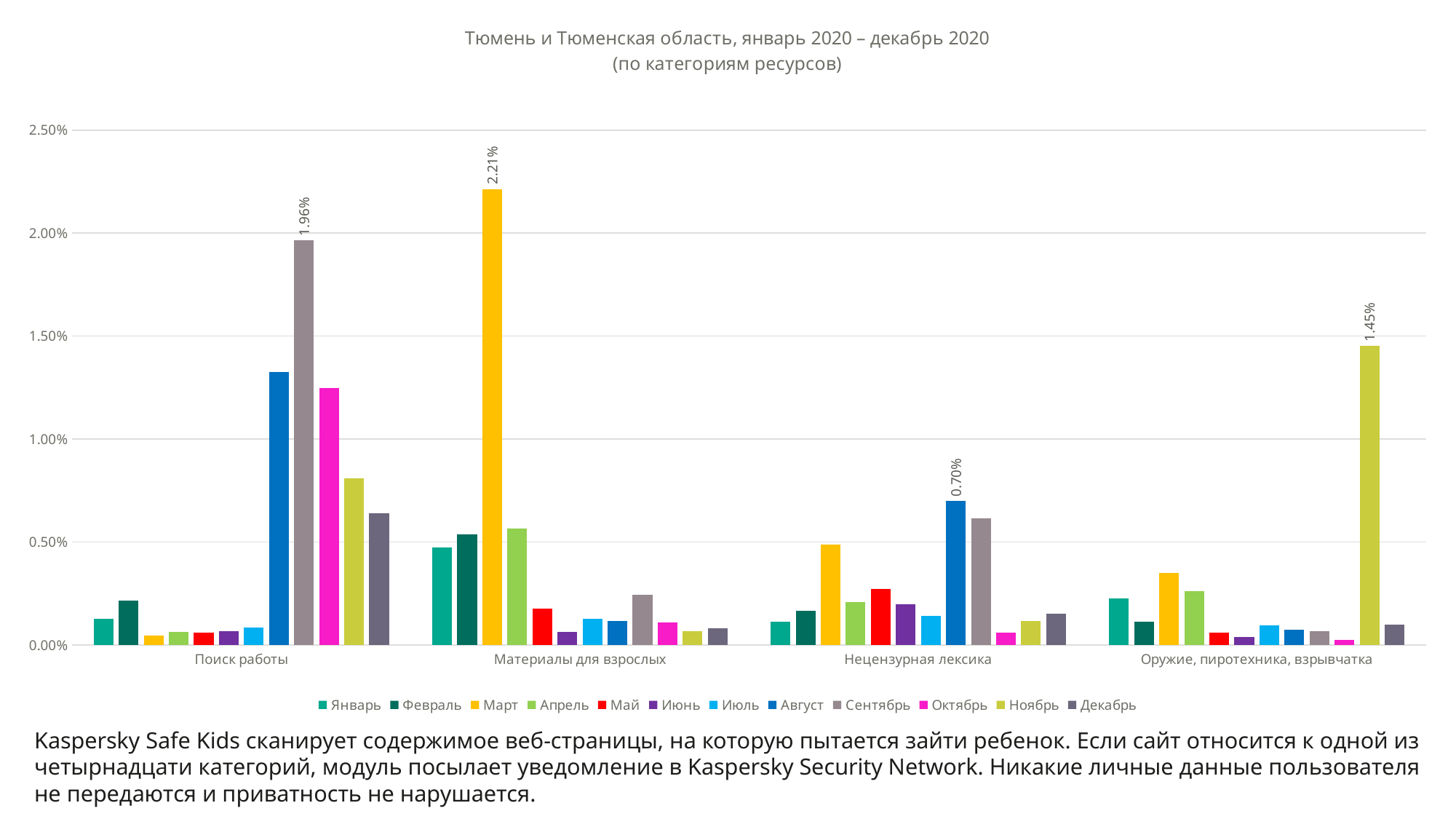
What is the value for Март in the Материалы для взрослых category? 2.21% What is the difference between the Март value for Материалы для взрослых (2.21%) and the Сентябрь value for Поиск работы (1.96%)? 0.25% How many resource categories are shown on the x axis? 4 Which month has the highest value in the Материалы для взрослых category? Март Is the value for Август in the Поиск работы category greater or less than 1.00%? greater Which month has the highest value in the Оружие, пиротехника, взрывчатка category? Ноябрь What is the value for Август in the Нецензурная лексика category? 0.70% What is the value for Сентябрь in the Поиск работы category? 1.96% Which is larger: the Сентябрь value for Поиск работы or the Ноябрь value for Оружие, пиротехника, взрывчатка? Сентябрь value for Поиск работы How many series does the legend list? 12 What type of chart is shown on the slide? bar chart What is the value for Ноябрь in the Оружие, пиротехника, взрывчатка category? 1.45%